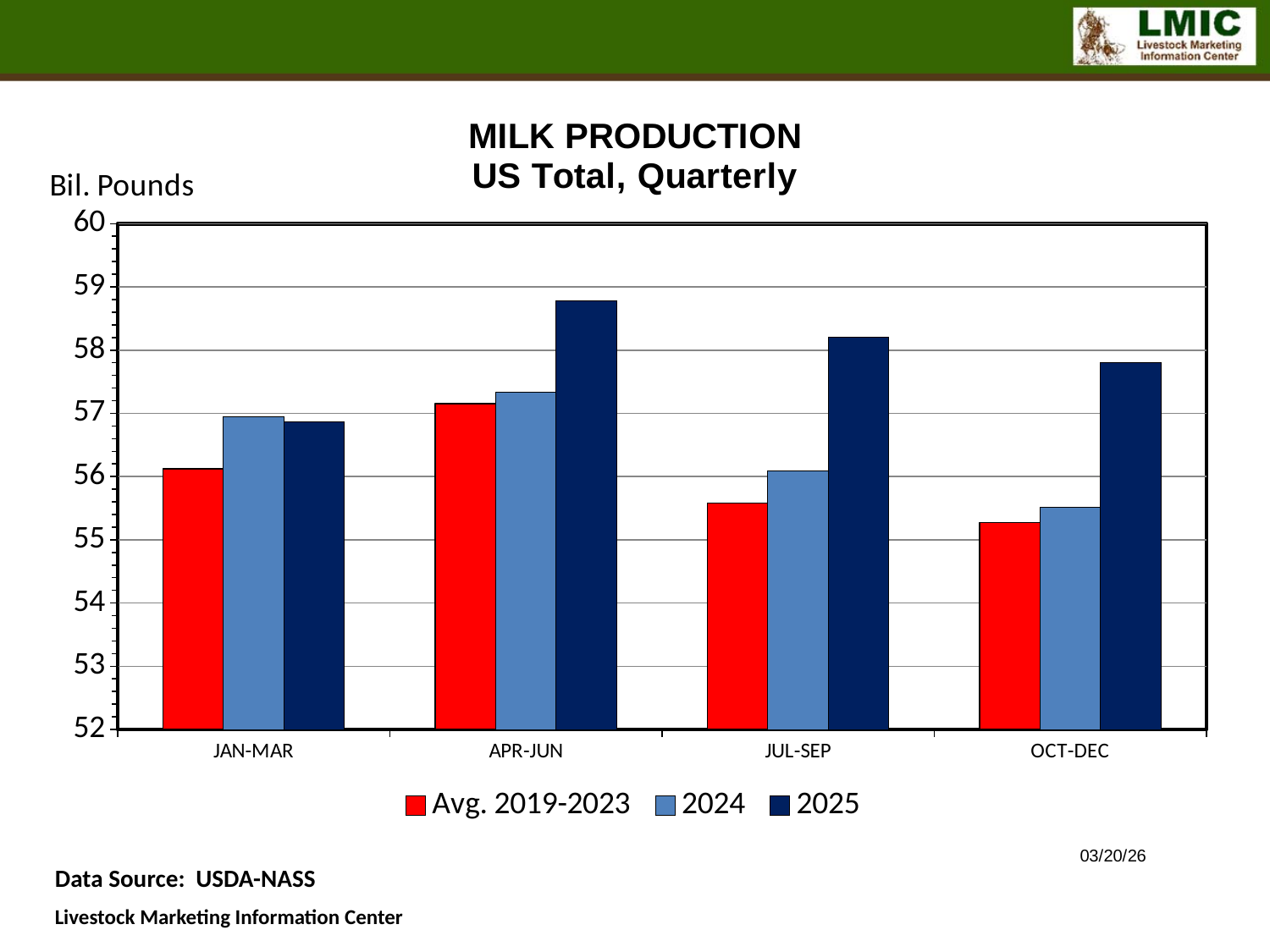
How many quarters are shown on the x axis? 4 For JUL-SEP, which is larger: the 2024 value or the 2025 value? 2025 Which quarter has the lowest value for the Avg. 2019-2023 series? OCT-DEC How many series does the legend list? 3 What unit is shown on the y axis of the chart? Bil. Pounds Is the 2025 value for APR-JUN greater or less than 58? greater What kind of chart is shown on the slide? bar chart Which quarter has the highest value for the 2025 series? APR-JUN For the Avg. 2019-2023 series, which is larger: APR-JUN or JUL-SEP? APR-JUN Is the Avg. 2019-2023 value for OCT-DEC greater or less than 56? less Is the 2025 value for OCT-DEC greater or less than 57? greater Does the Avg. 2019-2023 series rise or fall from APR-JUN to OCT-DEC? fall